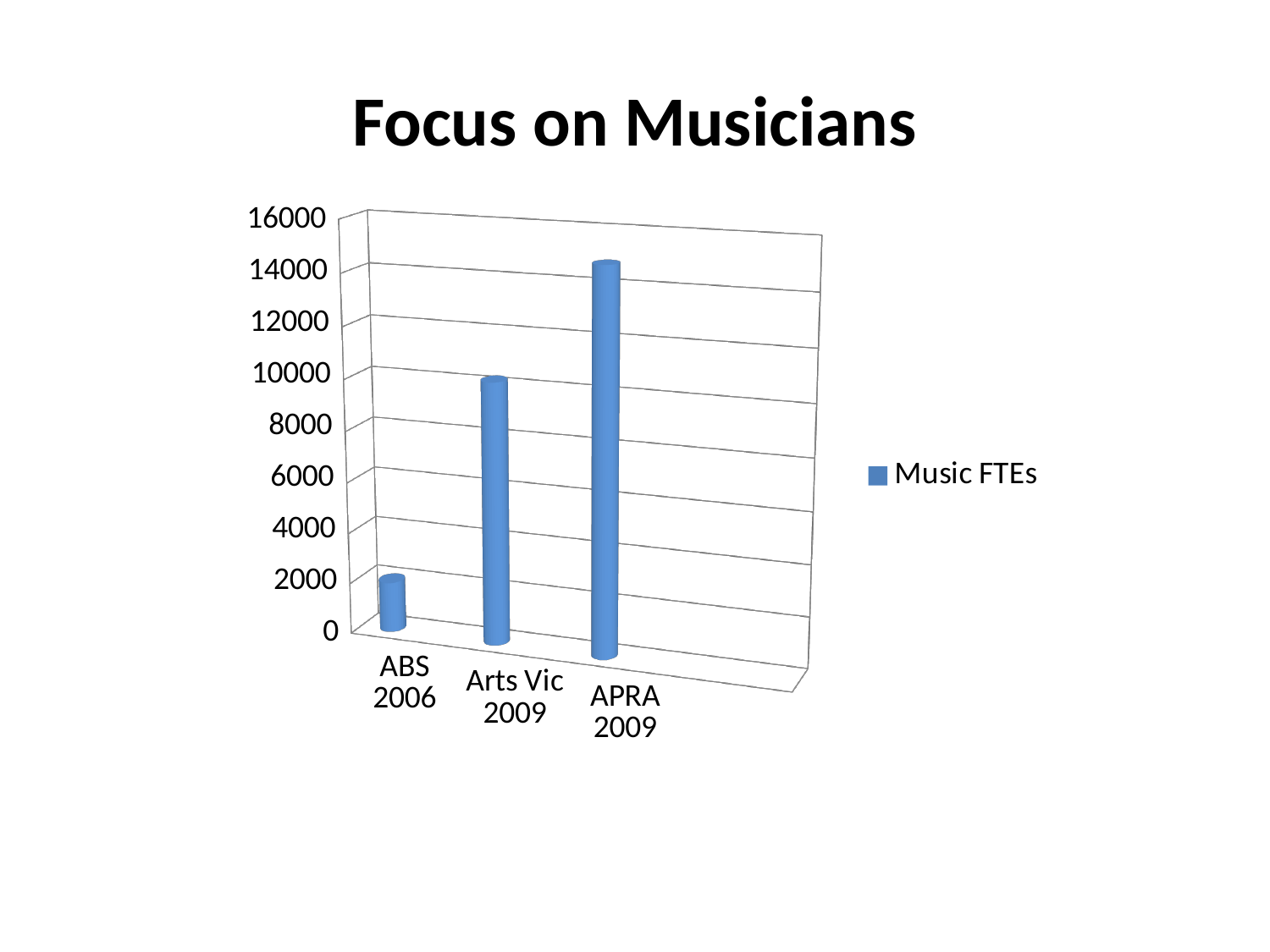
Is the value for APRA 2009 greater or less than 12000? greater What series name is shown in the chart's legend? Music FTEs How many series does the chart's legend list? 1 Which category has the highest Music FTEs value? APRA 2009 Which is larger, the value for APRA 2009 or the value for Arts Vic 2009? APRA 2009 Is the value for ABS 2006 greater or less than 4000? less Which category has the lowest Music FTEs value? ABS 2006 Do the values rise or fall moving from left to right along the x axis? rise What kind of chart is shown on the slide? bar chart How many categories are shown on the x axis of the chart? 3 Which is larger, the value for Arts Vic 2009 or the value for ABS 2006? Arts Vic 2009 Is the value for Arts Vic 2009 greater or less than 8000? greater